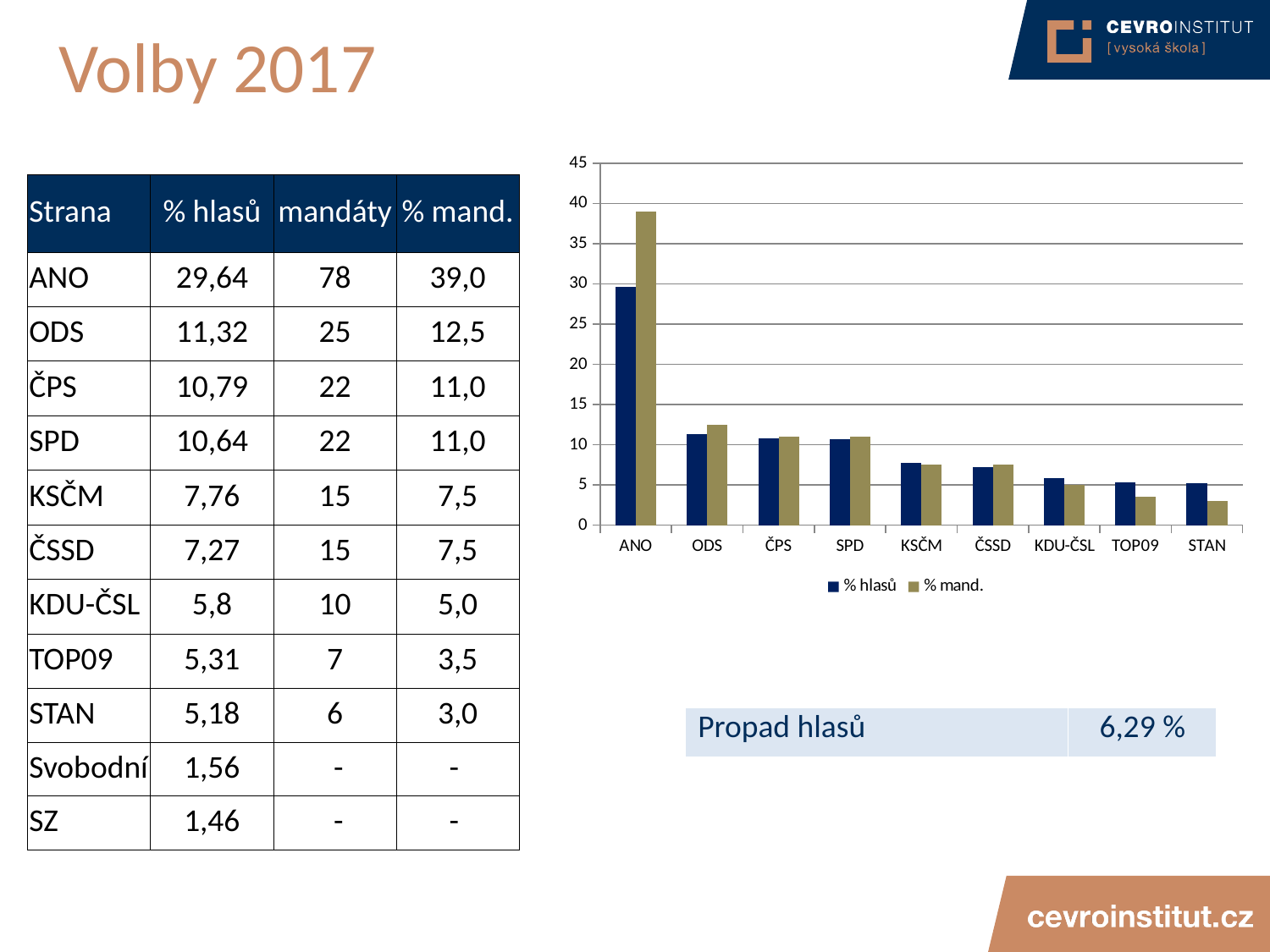
Which party has the highest % hlasů bar in the chart? ANO How many parties are shown on the x axis of the chart? 9 Which party has the highest % mand. bar in the chart? ANO Is the % mand. value for ANO greater or less than 35? greater What are the two legend entries of the chart? % hlasů and % mand. For ANO, which is larger: the % hlasů bar or the % mand. bar? % mand. What kind of chart is shown on the slide? bar chart How many series does the chart legend list? 2 Is the % hlasů value for KSČM greater or less than 5? greater Is the % hlasů value for ODS greater or less than 10? greater Do the % hlasů values rise or fall moving from ANO to STAN along the x axis? fall For TOP09, which is larger: the % hlasů bar or the % mand. bar? % hlasů